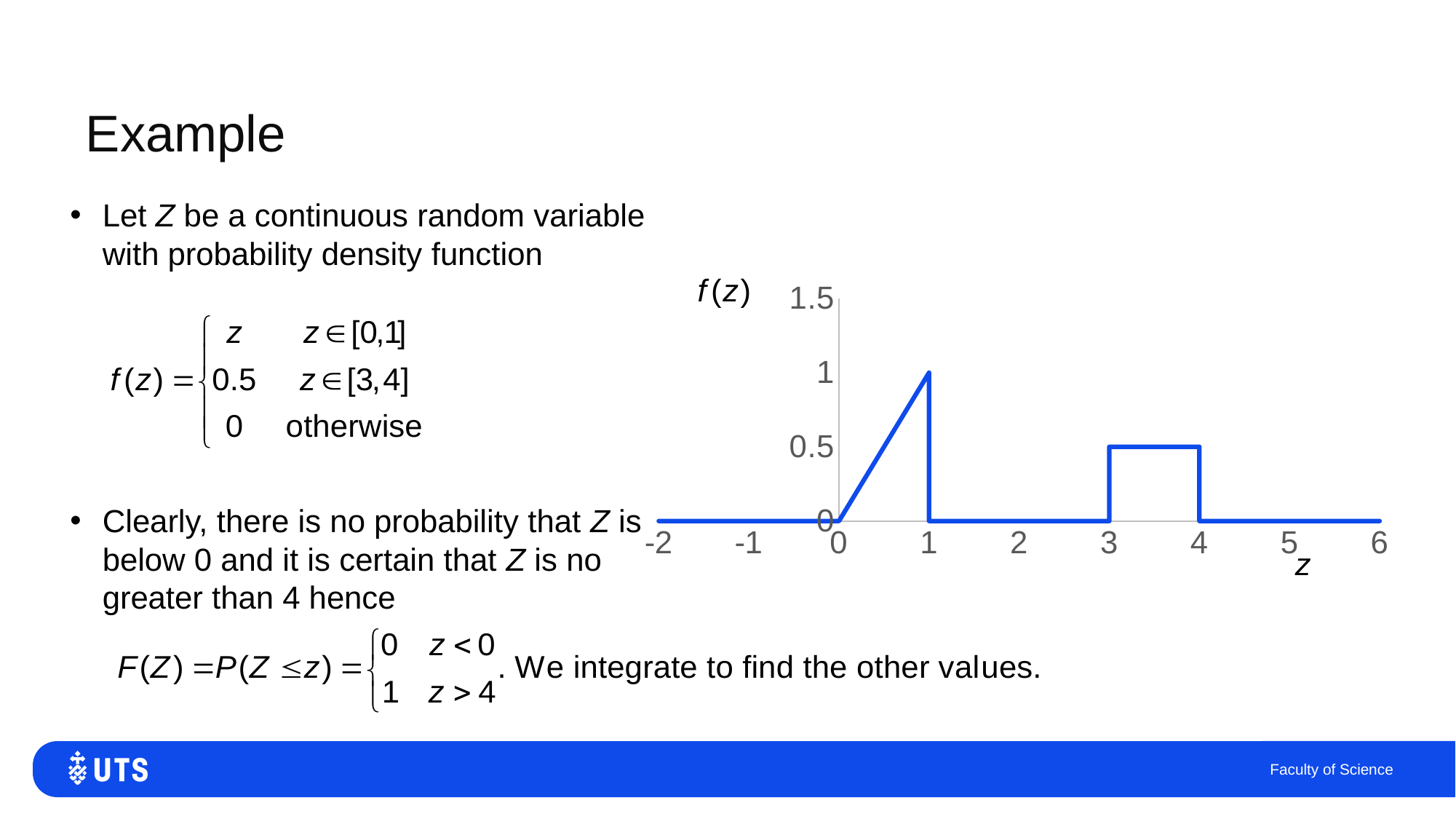
Is the value of f(z) at z = 3.5 greater or less than 1? less Which is larger: f(z) at z = 1 or f(z) at z = 3.5? f(z) at z = 1 Does f(z) rise or fall as z goes from 0 to 1? rise What is the value of f(z) at z = 2 on the chart? 0 What kind of chart is shown on the slide? line chart Is the value of f(z) at z = 1 greater or less than 0.5? greater What is the difference between f(z) at z = 1 and f(z) at z = 3.5? 0.5 What is the value of f(z) between z = 3 and z = 4 on the chart? 0.5 What is the label on the horizontal axis of the chart? z At which value of z does f(z) reach its peak? 1 What is the value of f(z) at z = 1 on the chart? 1 What is the highest value that f(z) reaches on the chart? 1